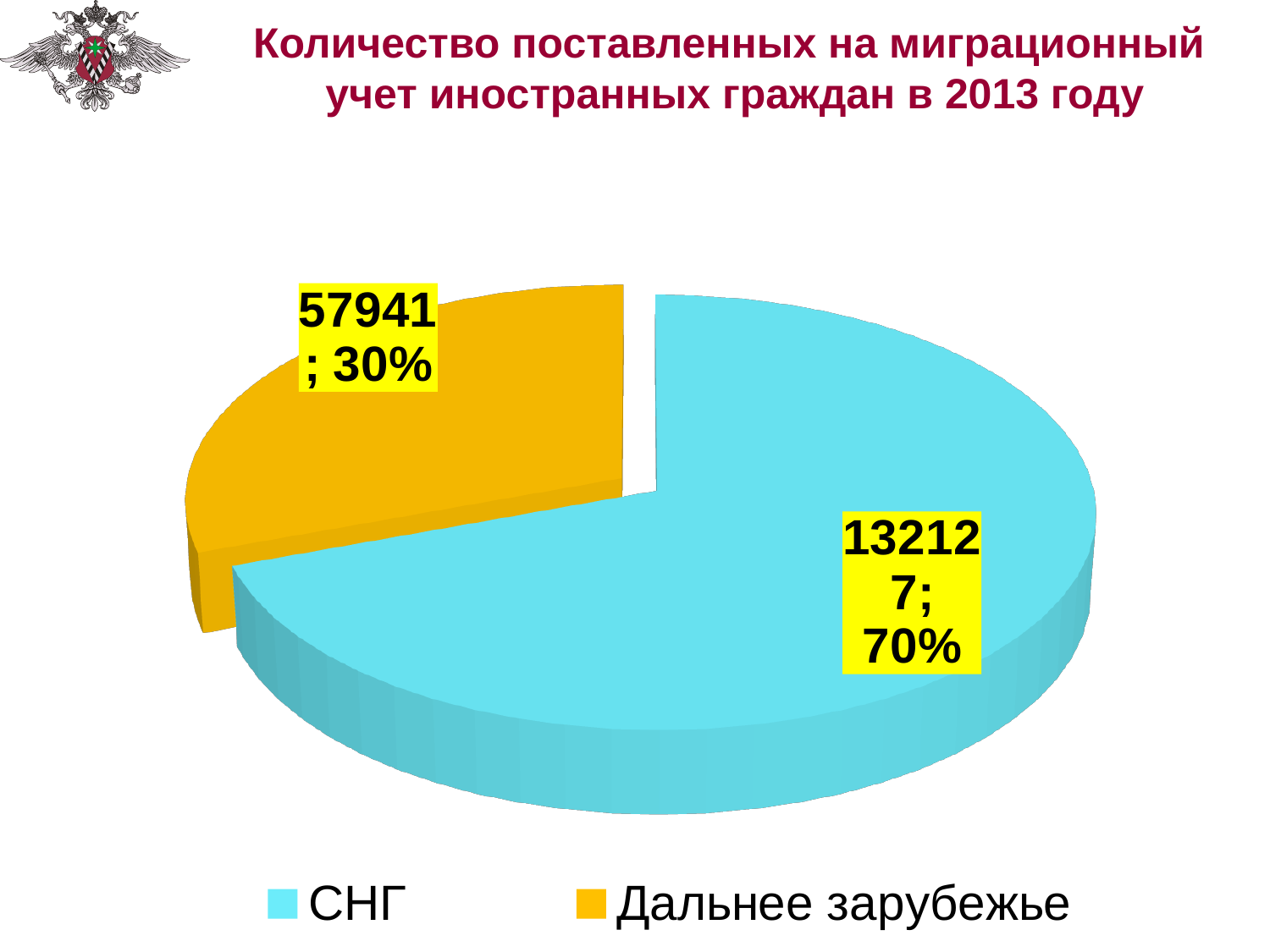
What share of the pie does СНГ represent? 70% What is the value for Дальнее зарубежье? 57941 What is the value for СНГ? 132127 Which category has the largest slice of the pie? СНГ What share of the pie does Дальнее зарубежье represent? 30% How many categories does the pie chart have? 2 What kind of chart is shown on the slide? pie chart Which is larger, the value for СНГ or the value for Дальнее зарубежье? СНГ What colour is the slice for Дальнее зарубежье? orange How many entries does the legend list? 2 What is the difference between the value for СНГ and the value for Дальнее зарубежье? 74186 Which category has the smallest slice of the pie? Дальнее зарубежье